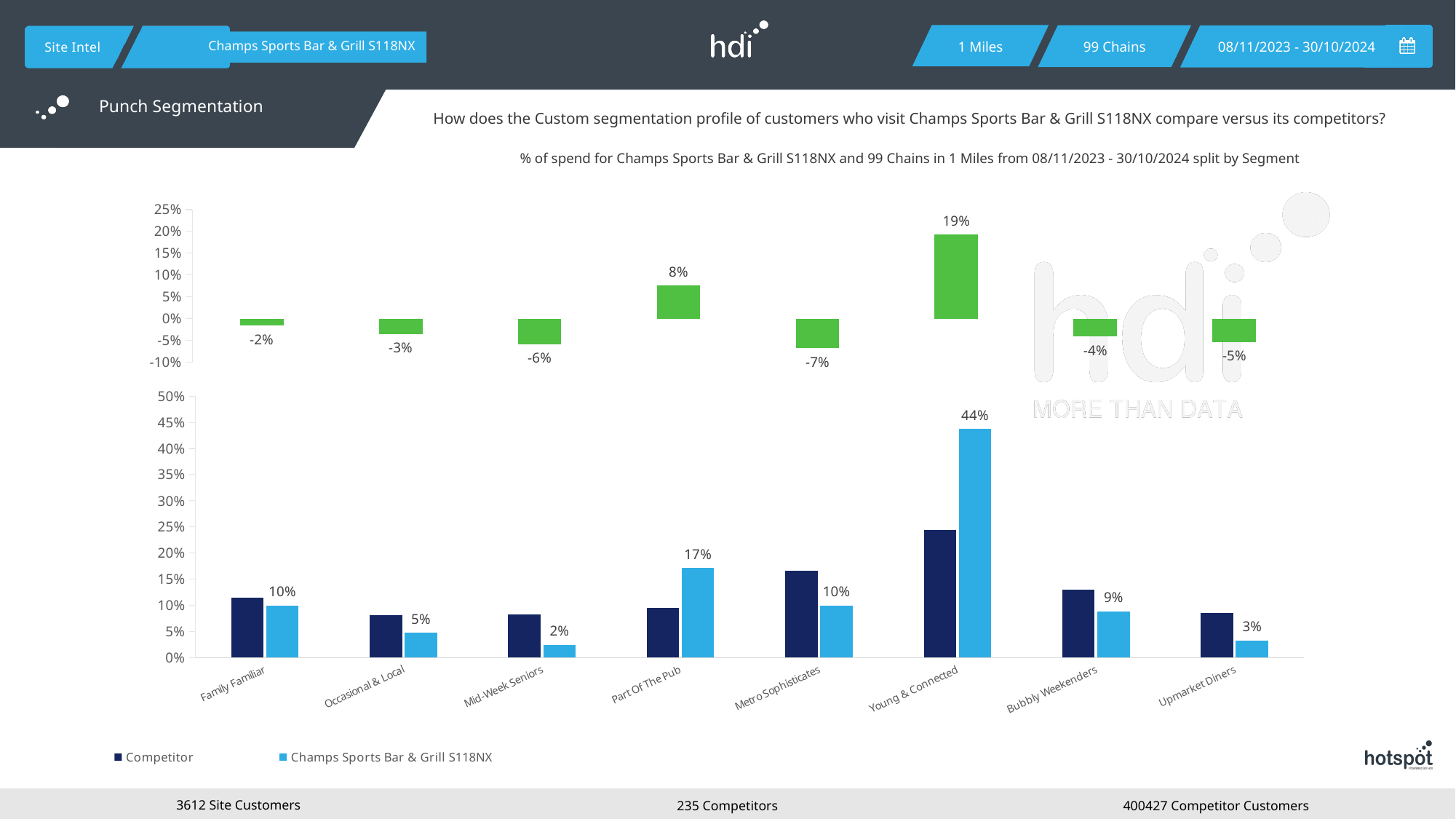
In the bottom chart, what is the Champs Sports Bar & Grill S118NX value for Part Of The Pub? 17% In the top chart, what is the value for Mid-Week Seniors? -6% In the bottom chart, what is the difference between the Champs Sports Bar & Grill S118NX values for Young & Connected and Part Of The Pub? 27% In the bottom chart, for Metro Sophisticates, which is larger: the Competitor bar or the Champs Sports Bar & Grill S118NX bar? Competitor How many segments are shown on the x axis of the bottom chart? 8 How many series does the legend of the bottom chart list? 2 In the top chart, which segment has the highest value? Young & Connected In the bottom chart, which segment has the highest Champs Sports Bar & Grill S118NX value? Young & Connected In the bottom chart, is the Competitor value for Young & Connected greater or less than 20%? greater In the top chart, which segment has the lowest value? Metro Sophisticates In the top chart, what is the value for Young & Connected? 19% In the bottom chart, which segment has the lowest Champs Sports Bar & Grill S118NX value? Mid-Week Seniors